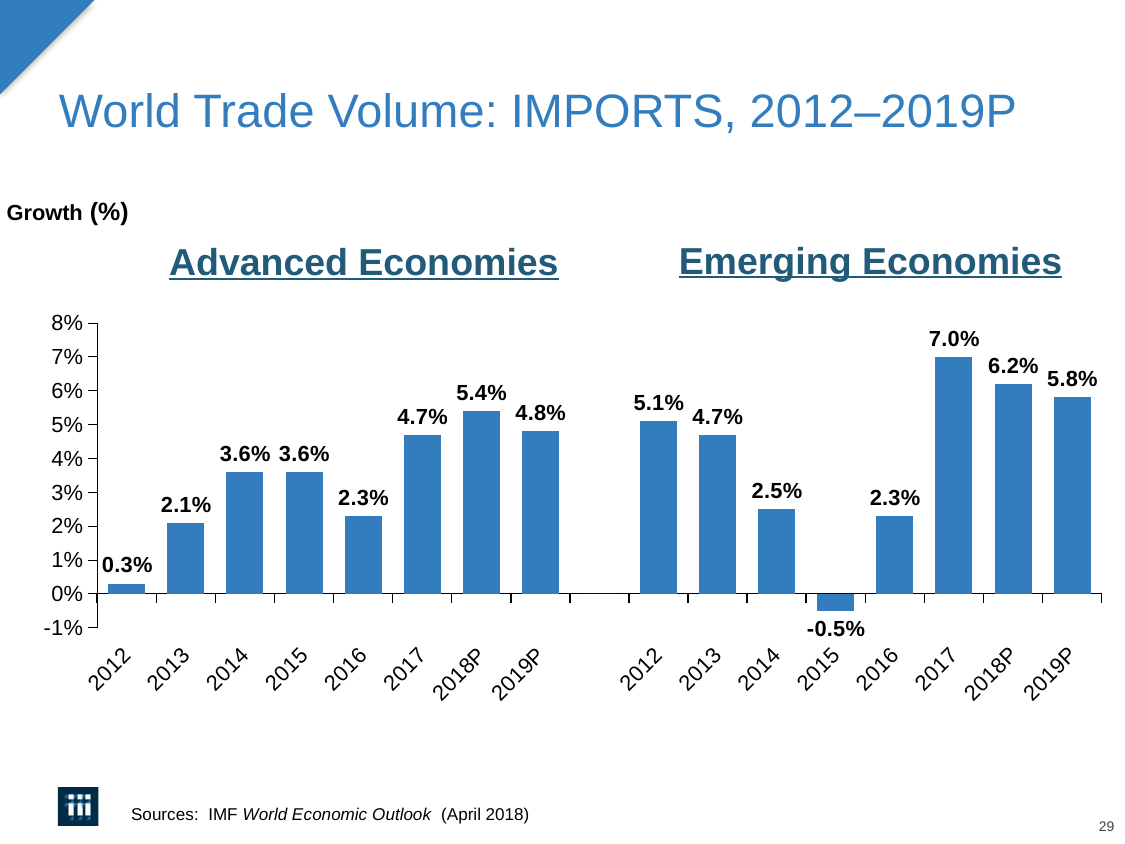
Which is larger: the Advanced Economies value for 2016 or the Emerging Economies value for 2014? Emerging Economies 2014 (2.5%) What kind of chart is shown on the slide? Bar chart What is the import growth value for Advanced Economies in 2017? 4.7% Which year has the highest import growth for Emerging Economies? 2017 Is the Emerging Economies value for 2017 greater or less than 6%? greater Did the Advanced Economies import growth rise or fall from 2016 to 2018P? Rise What is the import growth value for Emerging Economies in 2015? -0.5% How many years are plotted for Advanced Economies? 8 What is the title of the slide's chart? World Trade Volume: IMPORTS, 2012–2019P What is the difference between the Emerging Economies value for 2018P and the Advanced Economies value for 2018P? 0.8% What is the import growth value for Emerging Economies in 2019P? 5.8% Which year has the lowest import growth for Advanced Economies? 2012